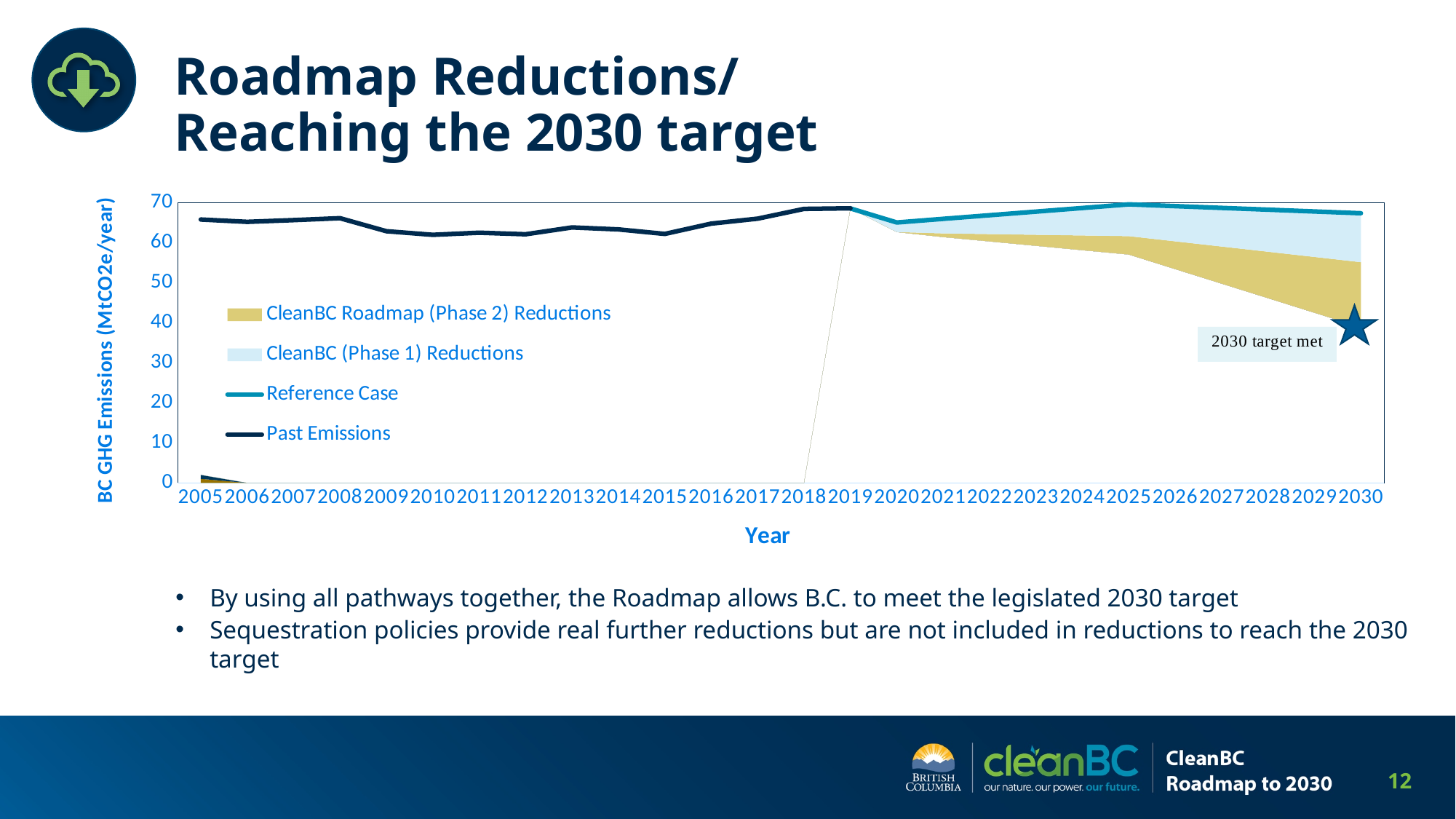
Does the Reference Case rise or fall between 2020 and 2025? rise What is the label on the y axis of the chart? BC GHG Emissions (MtCO2e/year) How many series does the chart legend list? 4 Is the Reference Case value for 2030 greater or less than 60? greater What text appears in the annotation next to the star at 2030? 2030 target met Is the Past Emissions value for 2018 greater or less than 60? greater Is the Past Emissions value for 2005 greater or less than 60? greater How many years are shown on the x axis of the chart? 26 What is the first year shown on the x axis? 2005 What is the last year shown on the x axis? 2030 Which year has the larger Past Emissions value, 2008 or 2015? 2008